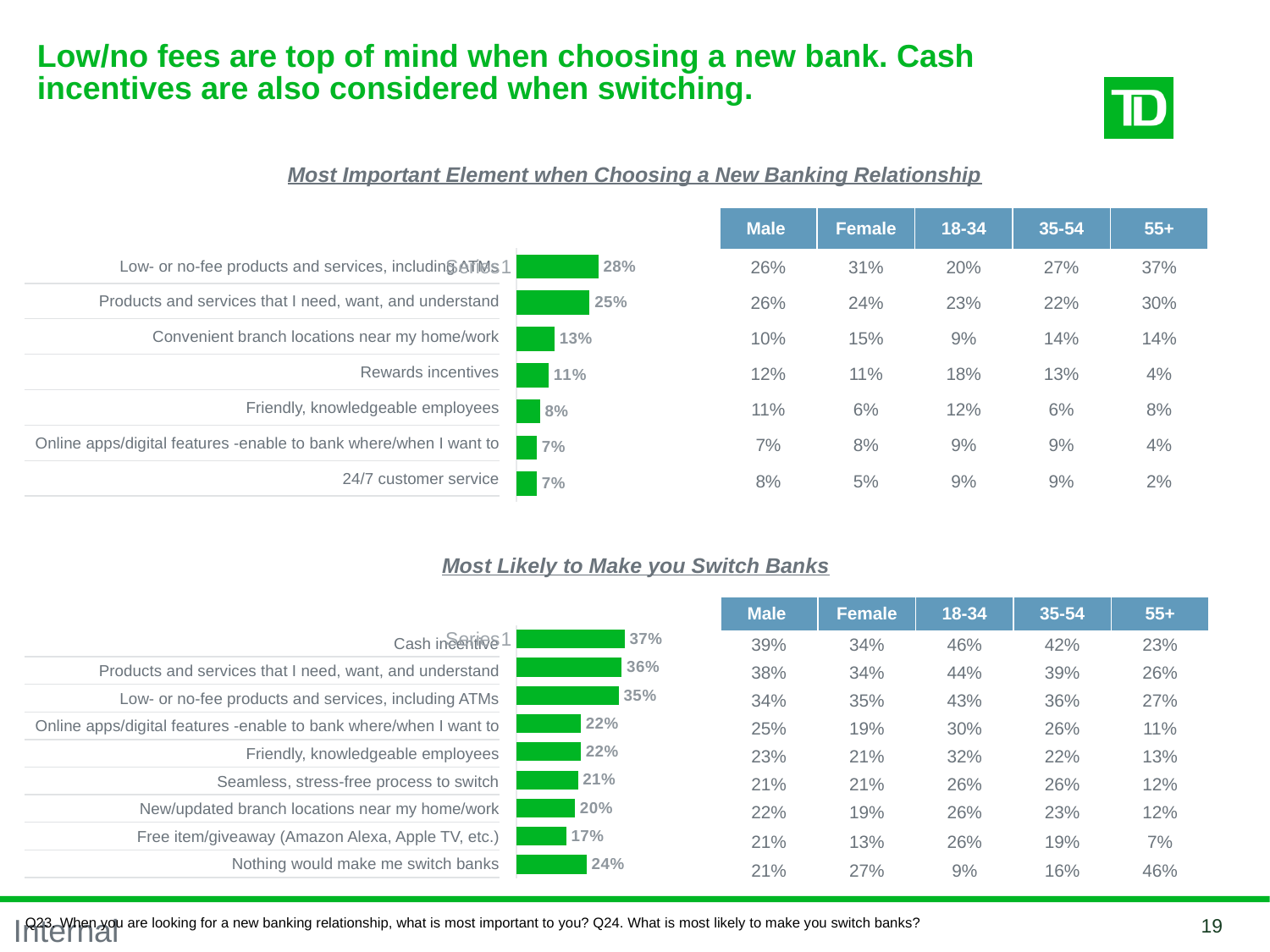
In the 'Most Important Element when Choosing a New Banking Relationship' chart, which is larger: 'Rewards incentives' or 'Friendly, knowledgeable employees'? Rewards incentives In the 'Most Likely to Make you Switch Banks' chart, what is the value for 'Cash incentive'? 37% In the 'Most Important Element when Choosing a New Banking Relationship' chart, what is the difference between 'Low- or no-fee products and services, including ATMs' and 'Products and services that I need, want, and understand'? 3% In the 'Most Likely to Make you Switch Banks' chart, how many categories are plotted? 9 In the 'Most Likely to Make you Switch Banks' chart, which category has the lowest value? Free item/giveaway (Amazon Alexa, Apple TV, etc.) What type of chart is used for 'Most Likely to Make you Switch Banks'? Bar chart In the 'Most Important Element when Choosing a New Banking Relationship' chart, which category has the highest value? Low- or no-fee products and services, including ATMs In the 'Most Important Element when Choosing a New Banking Relationship' chart, what is the value for 'Convenient branch locations near my home/work'? 13% In the 'Most Important Element when Choosing a New Banking Relationship' chart, how many categories are plotted? 7 In the 'Most Likely to Make you Switch Banks' chart, what is the difference between 'Cash incentive' and 'Seamless, stress-free process to switch'? 16% What is the title of the top chart on the slide? Most Important Element when Choosing a New Banking Relationship In the 'Most Likely to Make you Switch Banks' chart, what is the value for 'Nothing would make me switch banks'? 24%